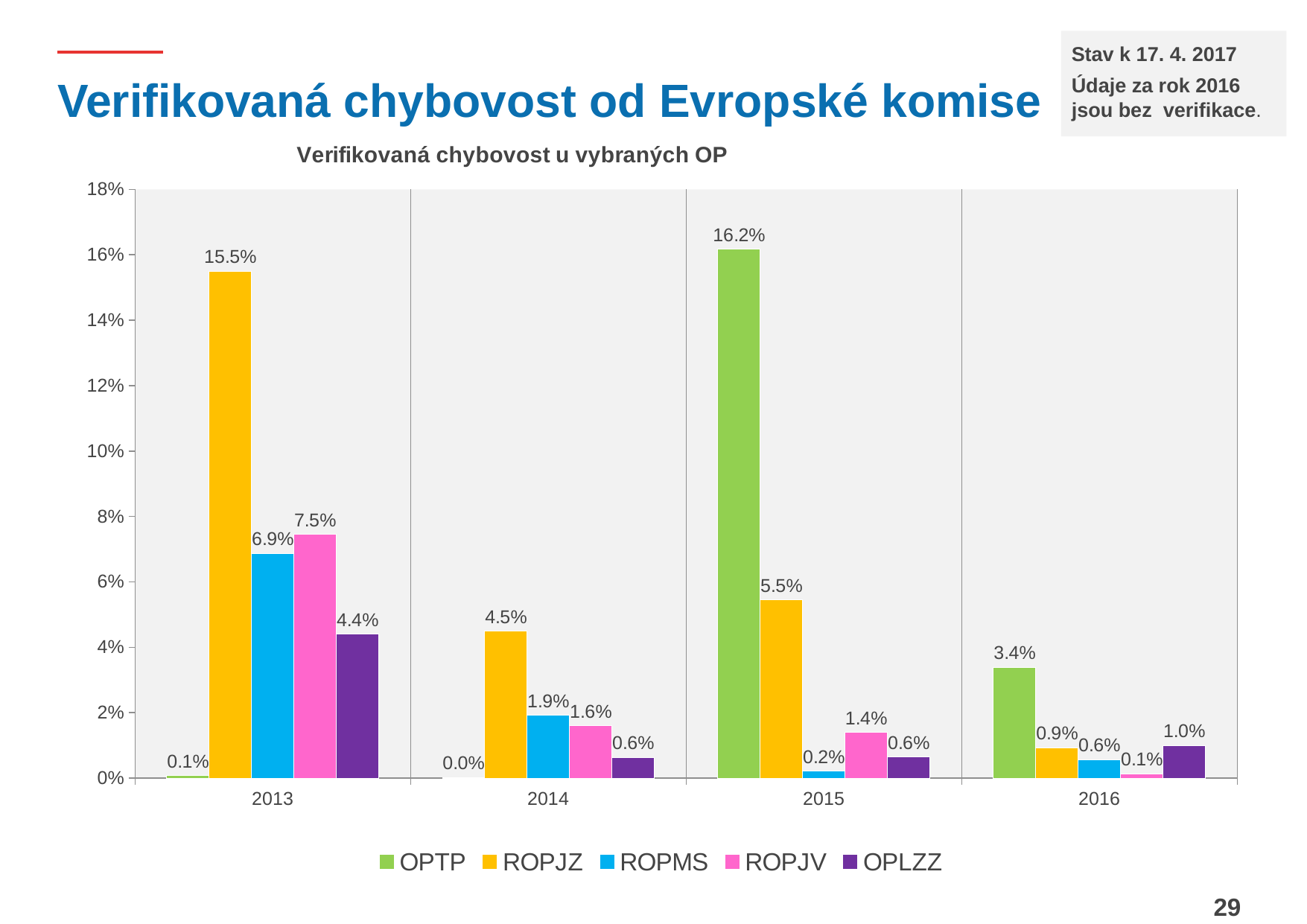
What is the value for ROPJZ in 2013? 15.5% What is the value for OPTP in 2015? 16.2% What is the value for OPLZZ in 2016? 1.0% What kind of chart is shown on the slide? bar chart What is the difference between the ROPJV and ROPMS values in 2013? 0.6% Which series has the lowest value in 2014? OPTP Does the value for ROPJZ rise or fall from 2013 to 2014? fall Which series has the highest value in 2013? ROPJZ Which is larger in 2015: the value for ROPJZ or the value for ROPJV? ROPJZ How many series does the legend list? 5 How many years are shown on the x axis? 4 What is the value for ROPMS in 2014? 1.9%